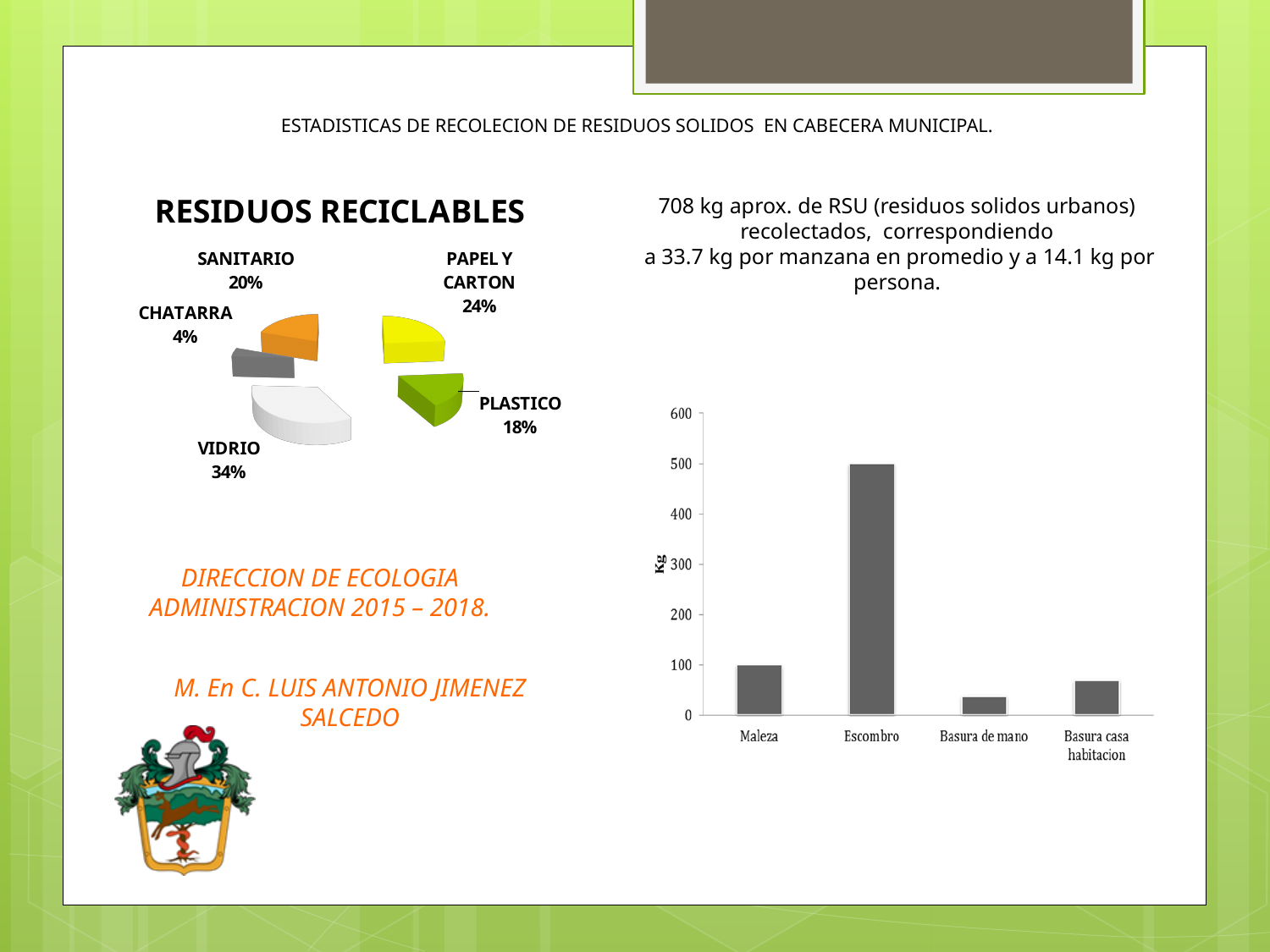
In the bar chart on the right, is the value for Escombro greater or less than 400? greater In the pie chart titled RESIDUOS RECICLABLES, which category has the largest share? VIDRIO What kind of chart is the chart on the right side of the slide with the Kg axis? Bar chart In the bar chart on the right, what is the label of the vertical axis? Kg In the bar chart on the right, which category has the lowest value? Basura de mano How many categories does the pie chart titled RESIDUOS RECICLABLES show? 5 In the pie chart titled RESIDUOS RECICLABLES, which is larger, PAPEL Y CARTON or SANITARIO? PAPEL Y CARTON In the pie chart titled RESIDUOS RECICLABLES, what share does VIDRIO have? 34% In the pie chart titled RESIDUOS RECICLABLES, what percentage is shown for PAPEL Y CARTON? 24% In the bar chart on the right, which category has the highest value? Escombro In the pie chart titled RESIDUOS RECICLABLES, what is the difference in percentage points between SANITARIO and PLASTICO? 2 In the pie chart titled RESIDUOS RECICLABLES, which category has the smallest share? CHATARRA